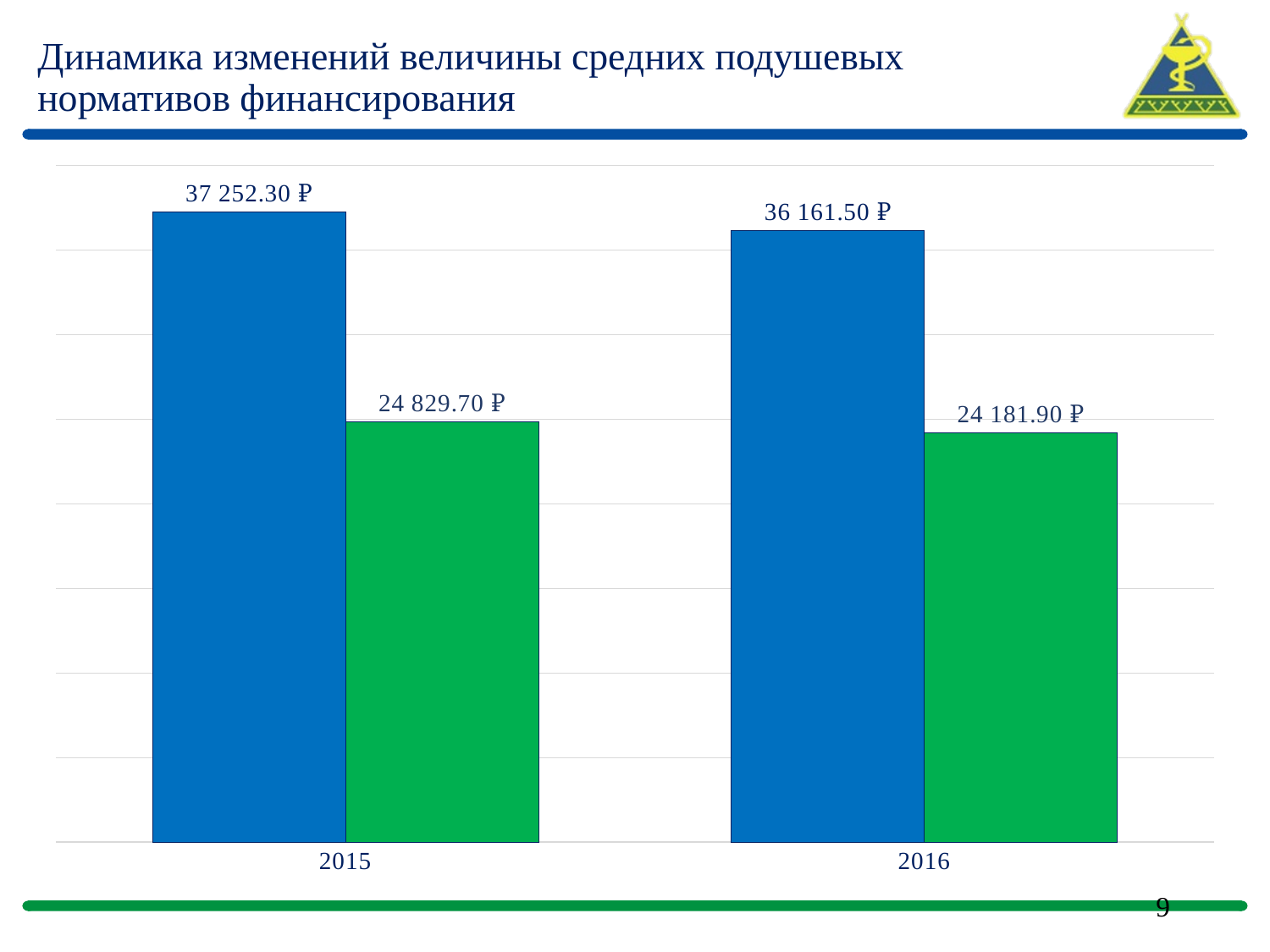
Do the blue bar values rise or fall from 2015 to 2016? fall What is the difference between the blue bar values for 2015 and 2016? 1 090.80 ₽ How many years are shown on the x axis? 2 What is the value of the blue bar for 2015? 37 252.30 ₽ What is the value of the green bar for 2015? 24 829.70 ₽ Is the green bar value for 2015 larger or smaller than the green bar value for 2016? larger What is the value of the green bar for 2016? 24 181.90 ₽ Which bar has the lowest value on the chart? The green bar for 2016 What type of chart is shown on the slide? Bar chart What is the value of the blue bar for 2016? 36 161.50 ₽ What is the difference between the blue and green bars for 2015? 12 422.60 ₽ Which year has the higher blue bar value? 2015